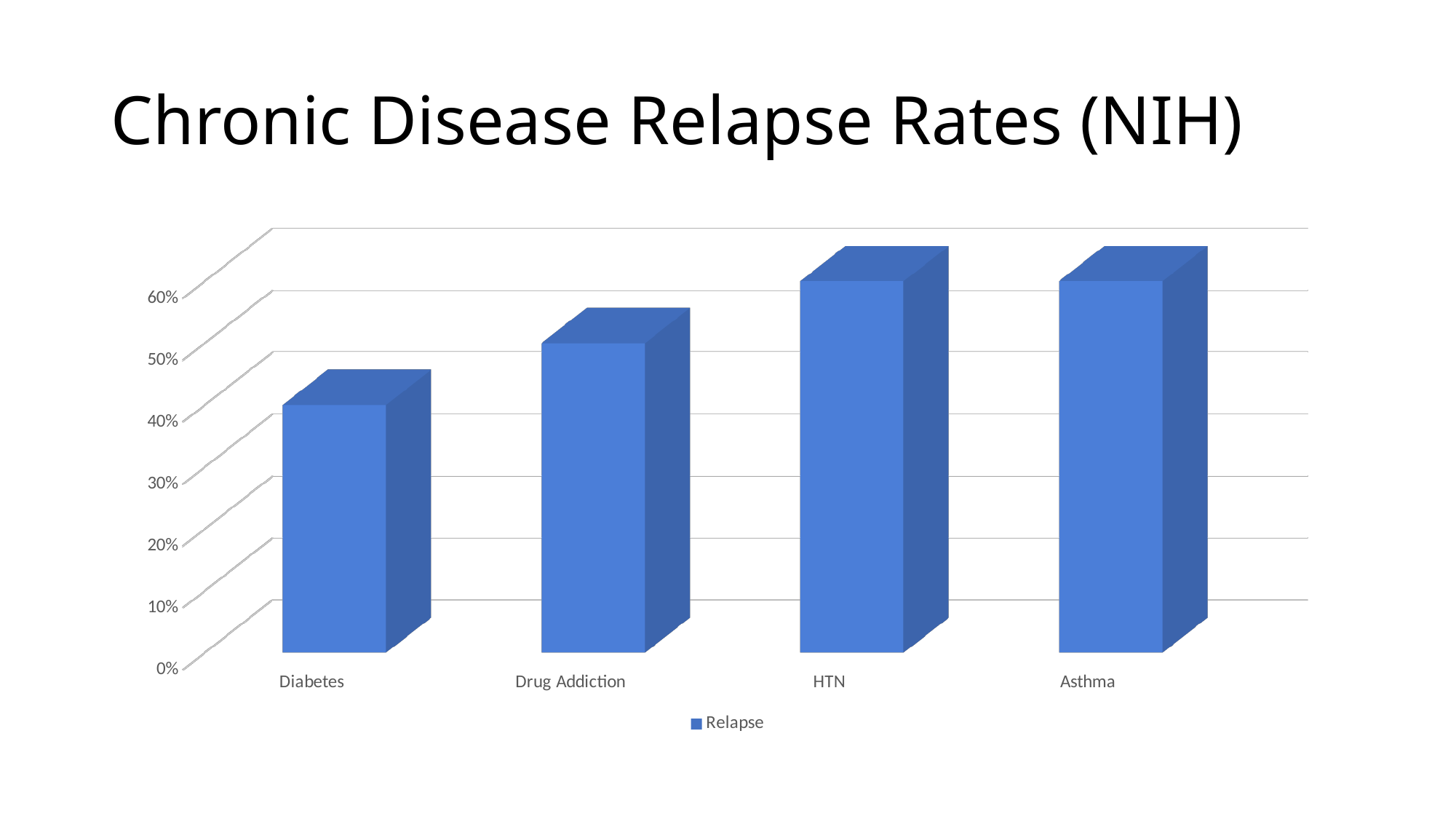
What is the title of the chart on the slide? Chronic Disease Relapse Rates (NIH) Is the value for Diabetes greater or less than 50%? less Is the value for HTN greater or less than 50%? greater What is the name of the series shown in the legend? Relapse Which category has the lowest relapse rate? Diabetes Is the value for Diabetes greater or less than 30%? greater What kind of chart is shown on the slide? bar chart How many categories are plotted on the chart? 4 How many series does the legend list? 1 Which is larger, the relapse rate for Drug Addiction or for Diabetes? Drug Addiction